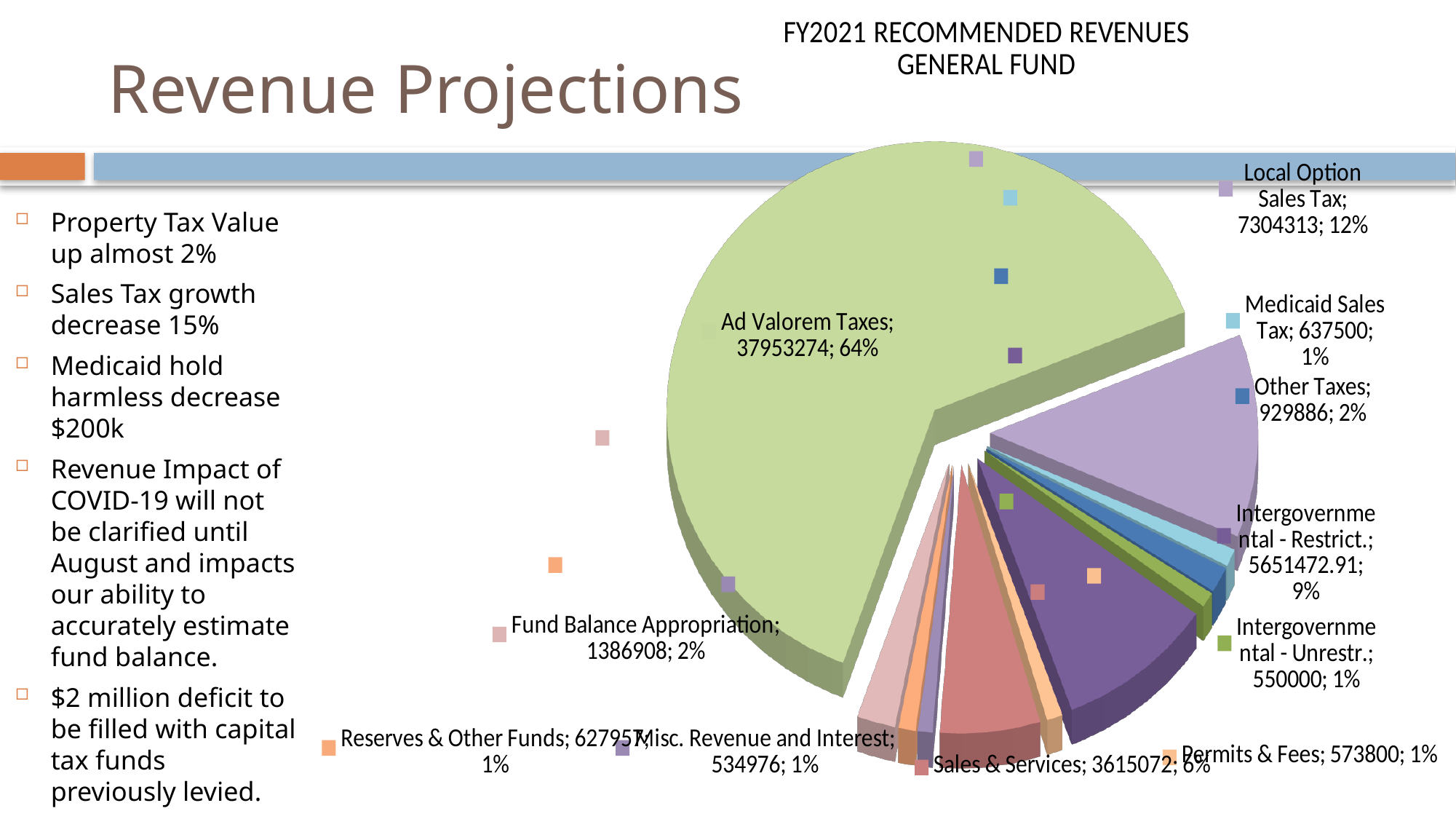
What kind of chart is shown on the slide? Pie chart What share of the pie does Ad Valorem Taxes represent? 64% What is the title of the chart? FY2021 RECOMMENDED REVENUES GENERAL FUND What is the value shown for Permits & Fees? 573800 What is the value shown for Intergovernmental - Restrict.? 5651472.91 Which is larger, Local Option Sales Tax or Sales & Services? Local Option Sales Tax What is the difference between the values for Other Taxes and Medicaid Sales Tax? 292386 How many categories are shown in the pie chart? 11 What percentage of the pie is Fund Balance Appropriation? 2% What is the value shown for Local Option Sales Tax? 7304313 What is the value shown for Sales & Services? 3615072 Which category has the largest slice of the pie? Ad Valorem Taxes